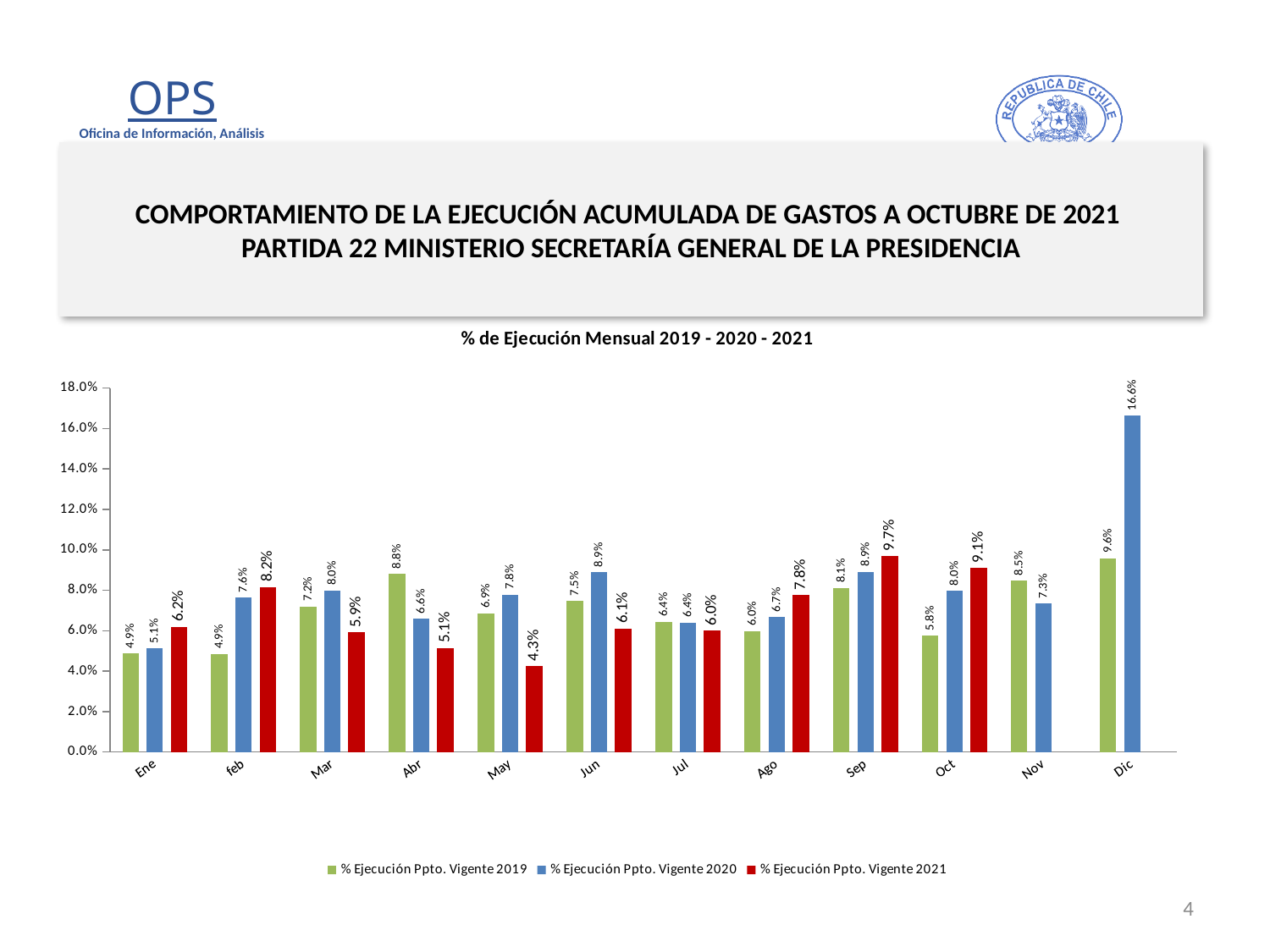
Which month has the lowest value for % Ejecución Ppto. Vigente 2021? May What is the difference between the 2021 and 2019 values in Oct? 3.3% How many months are shown on the x axis? 12 What kind of chart is shown on the slide? Bar chart What is the value for % Ejecución Ppto. Vigente 2021 in Sep? 9.7% Which month has the highest value for % Ejecución Ppto. Vigente 2020? Dic What is the value for % Ejecución Ppto. Vigente 2020 in Dic? 16.6% Which month has the highest value for % Ejecución Ppto. Vigente 2021? Sep Which is larger in Mar: the 2020 value or the 2021 value? 2020 value (8.0%) What is the value for % Ejecución Ppto. Vigente 2019 in Abr? 8.8% Is the value for % Ejecución Ppto. Vigente 2020 in Dic greater or less than 14.0%? greater How many series does the legend list? 3